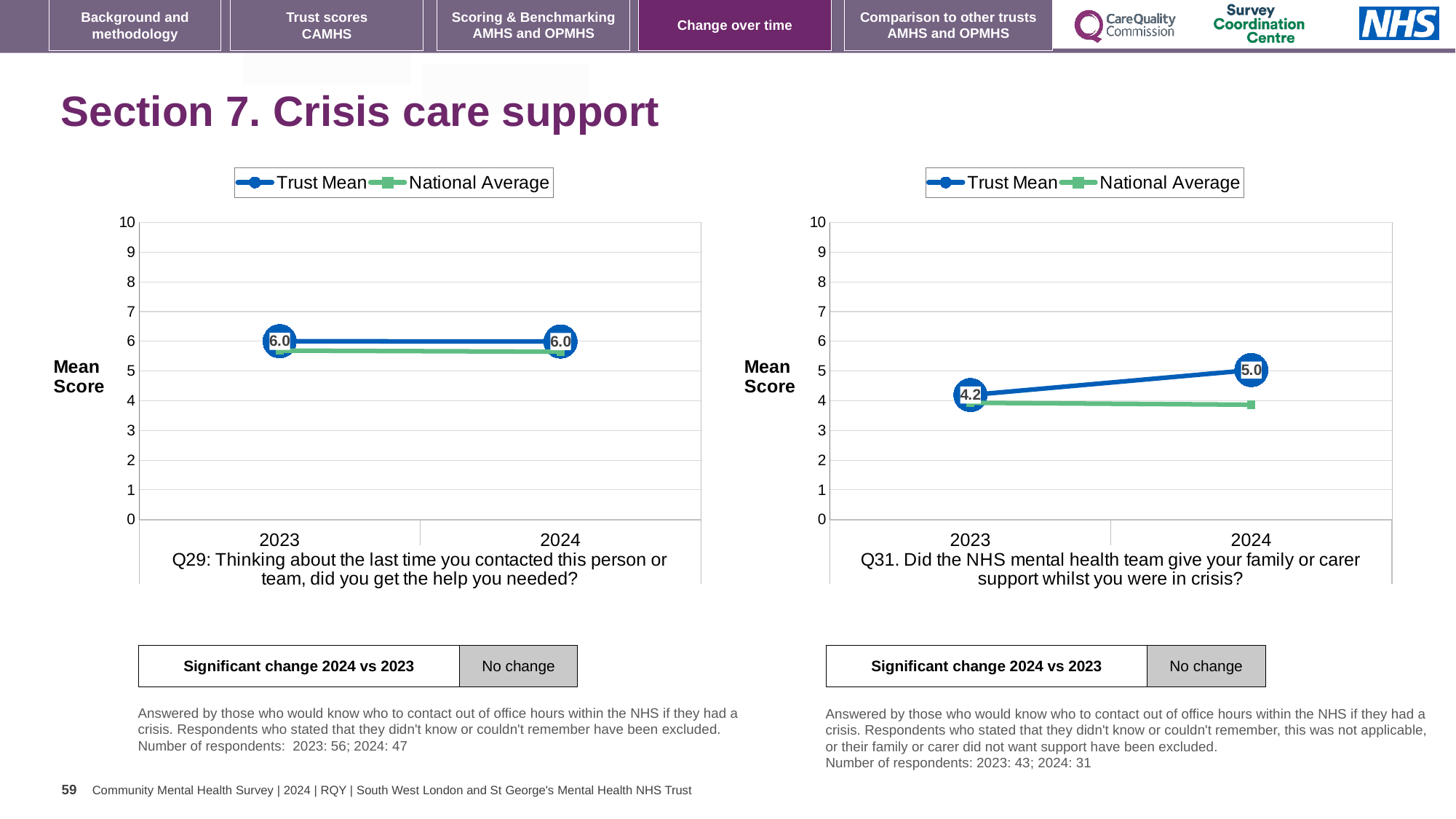
In the right chart (Q31), by how much did the Trust Mean change from 2023 to 2024? 0.8 In the left chart (Q29), what is the Trust Mean score for 2023? 6.0 In the right chart (Q31), what is the Trust Mean score for 2023? 4.2 In the left chart (Q29), is the National Average for 2023 greater or less than 5? greater In the right chart (Q31), which year has the higher Trust Mean score? 2024 In the left chart (Q29), what is the Trust Mean score for 2024? 6.0 What kind of chart is the right chart (Q31)? line chart How many series does the legend of the left chart (Q29) list? 2 In the right chart (Q31), what is the Trust Mean score for 2024? 5.0 In the right chart (Q31), does the Trust Mean rise or fall from 2023 to 2024? rise In the right chart (Q31), which is larger in 2024, the Trust Mean or the National Average? Trust Mean